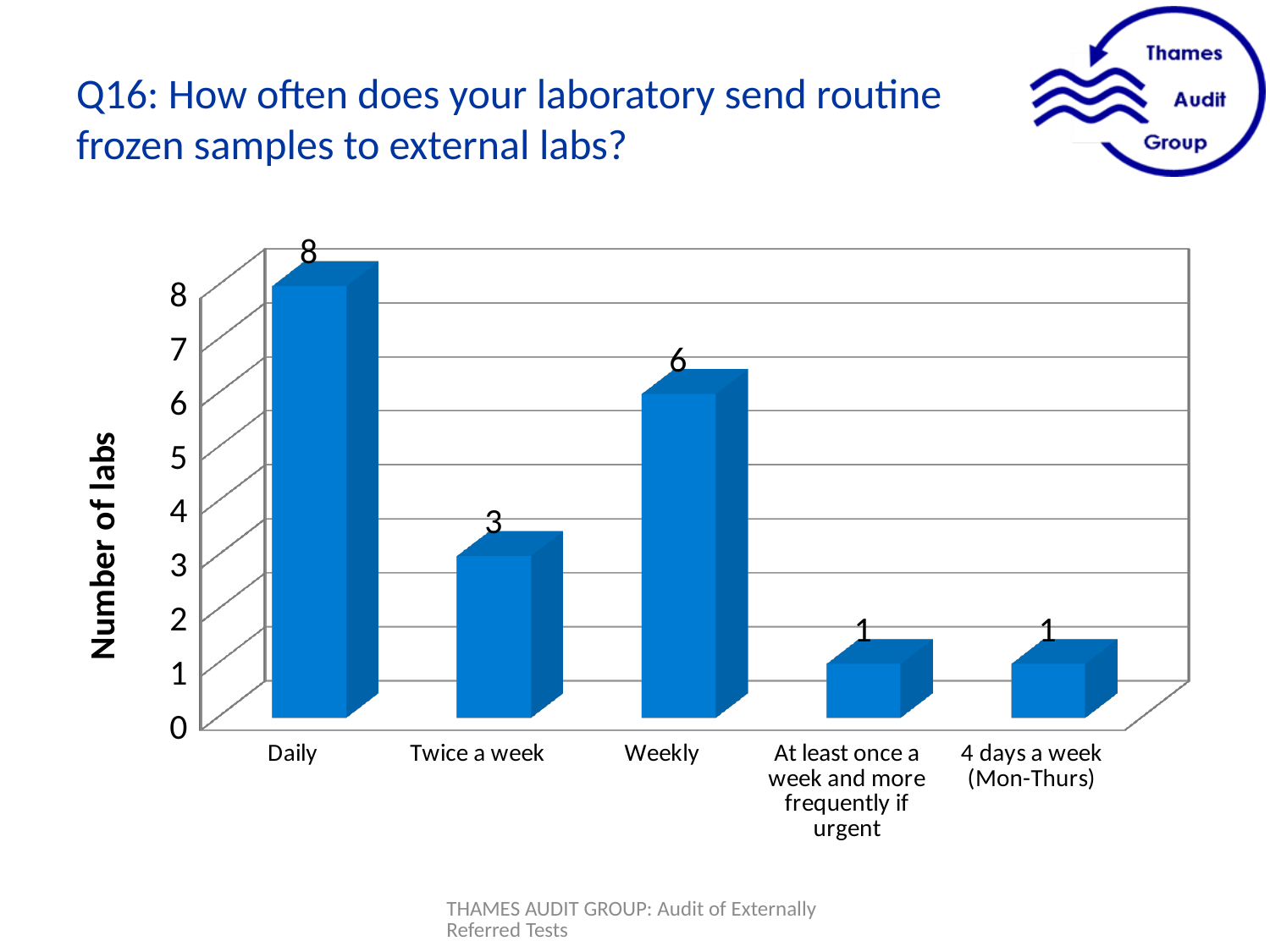
How many categories are shown on the x axis of the chart? 5 What is the difference in number of labs between 'Daily' and 'Weekly'? 2 What is the total number of labs across all five categories? 19 How many labs send routine frozen samples to external labs daily? 8 What is the number of labs for the 'Weekly' category? 6 What is the number of labs for the 'Twice a week' category? 3 Which has more labs, 'Twice a week' or 'Weekly'? Weekly What is the difference in number of labs between 'Weekly' and 'Twice a week'? 3 What is the label of the vertical axis of the chart? Number of labs What kind of chart is shown on the slide? Bar chart Which category has the highest number of labs? Daily How many labs send samples '4 days a week (Mon-Thurs)'? 1